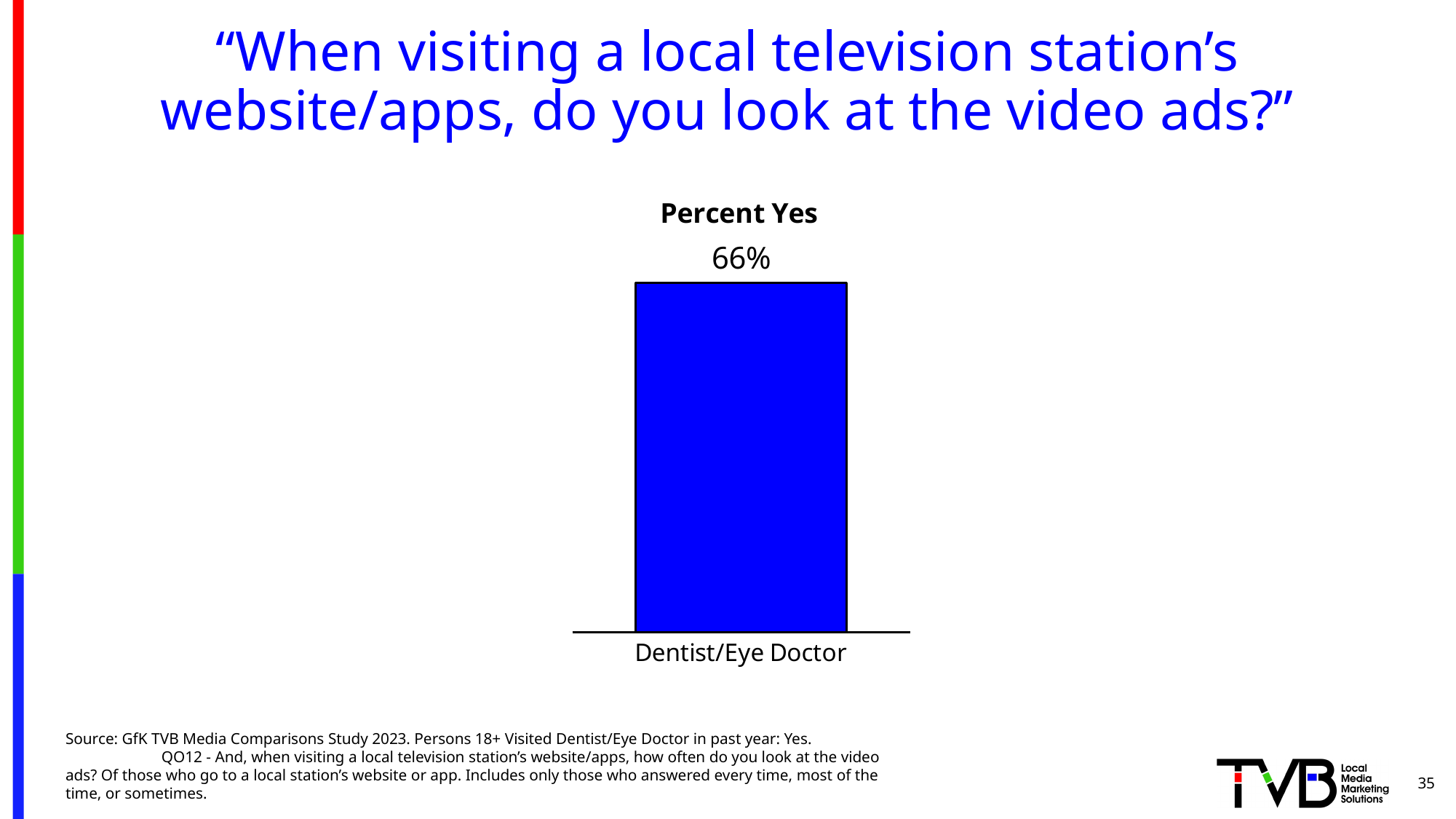
What is the Percent Yes value for Dentist/Eye Doctor? 66% What category label appears under the bar? Dentist/Eye Doctor How many categories are plotted in the chart? 1 Is the Percent Yes value for Dentist/Eye Doctor greater or less than 50%? greater What kind of chart is shown on the slide? bar chart What is the title of the chart? Percent Yes